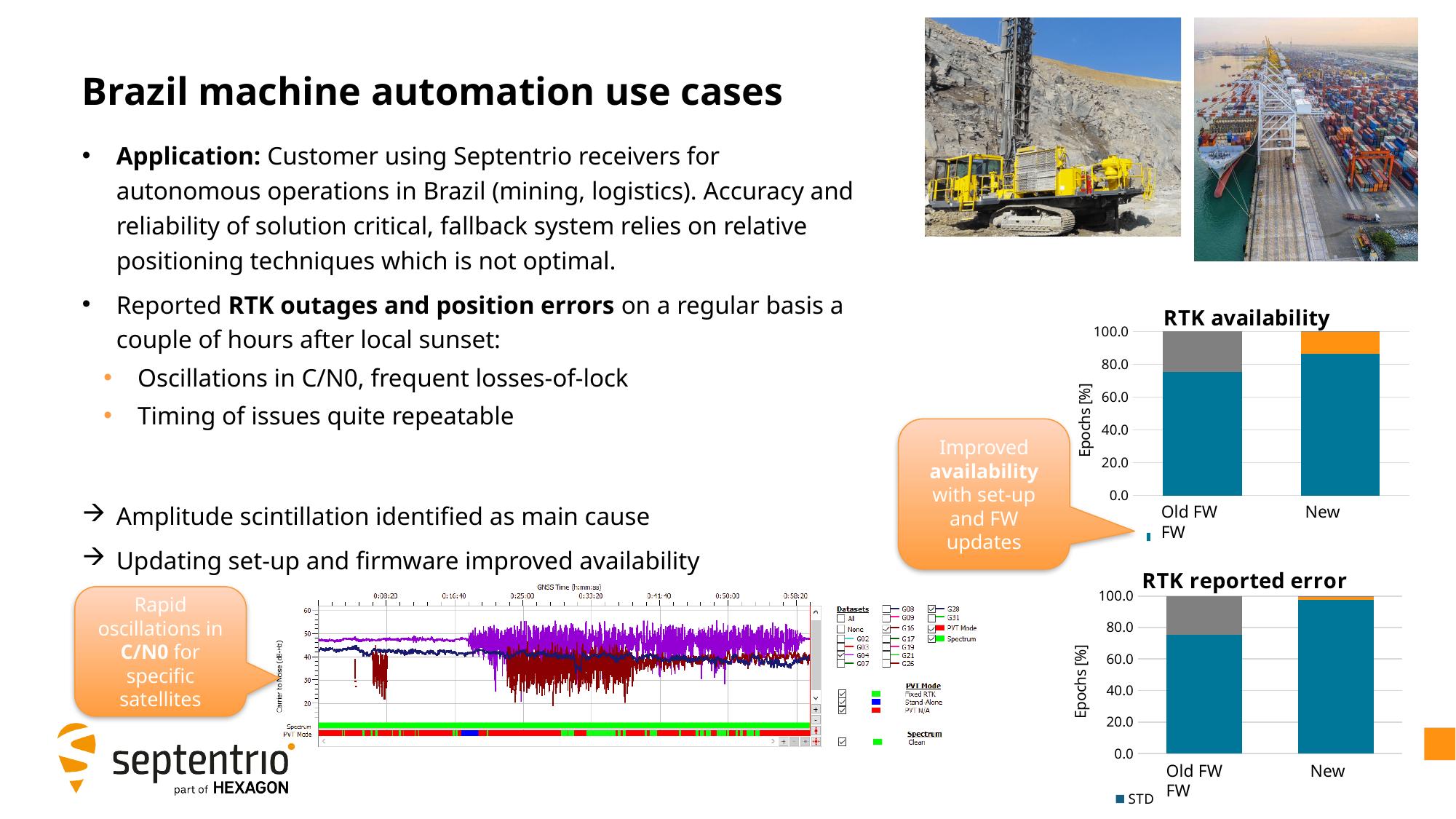
In the "RTK availability" chart, what is the total height of the stacked bar for Old FW? 100.0 In the "RTK availability" chart, is the teal (bottom) segment for Old FW greater or less than 60.0? greater In the "RTK availability" chart, is the teal (bottom) segment for New FW greater or less than 80.0? greater What is the y-axis label of the "RTK reported error" chart? Epochs [%] What is the title of the upper bar chart on the right side of the slide? RTK availability In the "RTK reported error" chart, is the teal (bottom) segment for New FW greater or less than 80.0? greater What kind of chart is the "RTK reported error" chart? bar chart How many categories are shown on the x axis of the "RTK availability" chart? 2 What kind of chart is the "RTK availability" chart? bar chart In the "RTK availability" chart, which category has the larger teal (bottom) segment, Old FW or New FW? New FW In the "RTK reported error" chart, which category has the larger teal (bottom) segment, Old FW or New FW? New FW